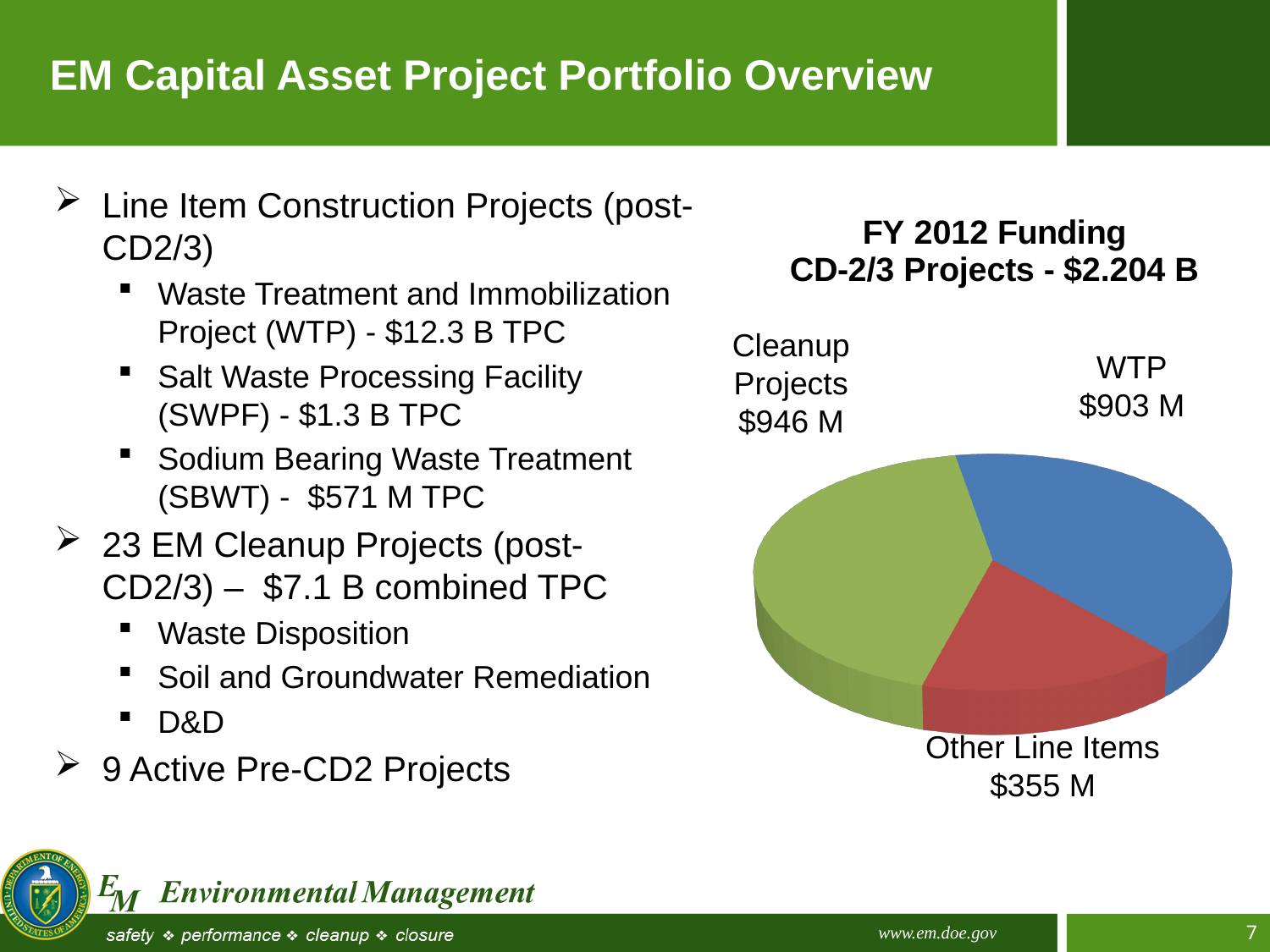
What is the FY 2012 funding value for Cleanup Projects in the pie chart? $946 M Which slice of the pie chart has the largest value? Cleanup Projects What is the FY 2012 funding value for Other Line Items in the pie chart? $355 M What is the difference between the WTP and Other Line Items values in the pie chart? $548 M What is the FY 2012 funding value for WTP in the pie chart? $903 M What is the title of the pie chart? FY 2012 Funding CD-2/3 Projects - $2.204 B How many slices does the pie chart have? 3 Which is larger in the pie chart, WTP or Other Line Items? WTP What colour is the Cleanup Projects slice in the pie chart? Green What is the difference between the Cleanup Projects and WTP values in the pie chart? $43 M Which slice of the pie chart has the smallest value? Other Line Items What type of chart is shown on the slide? Pie chart